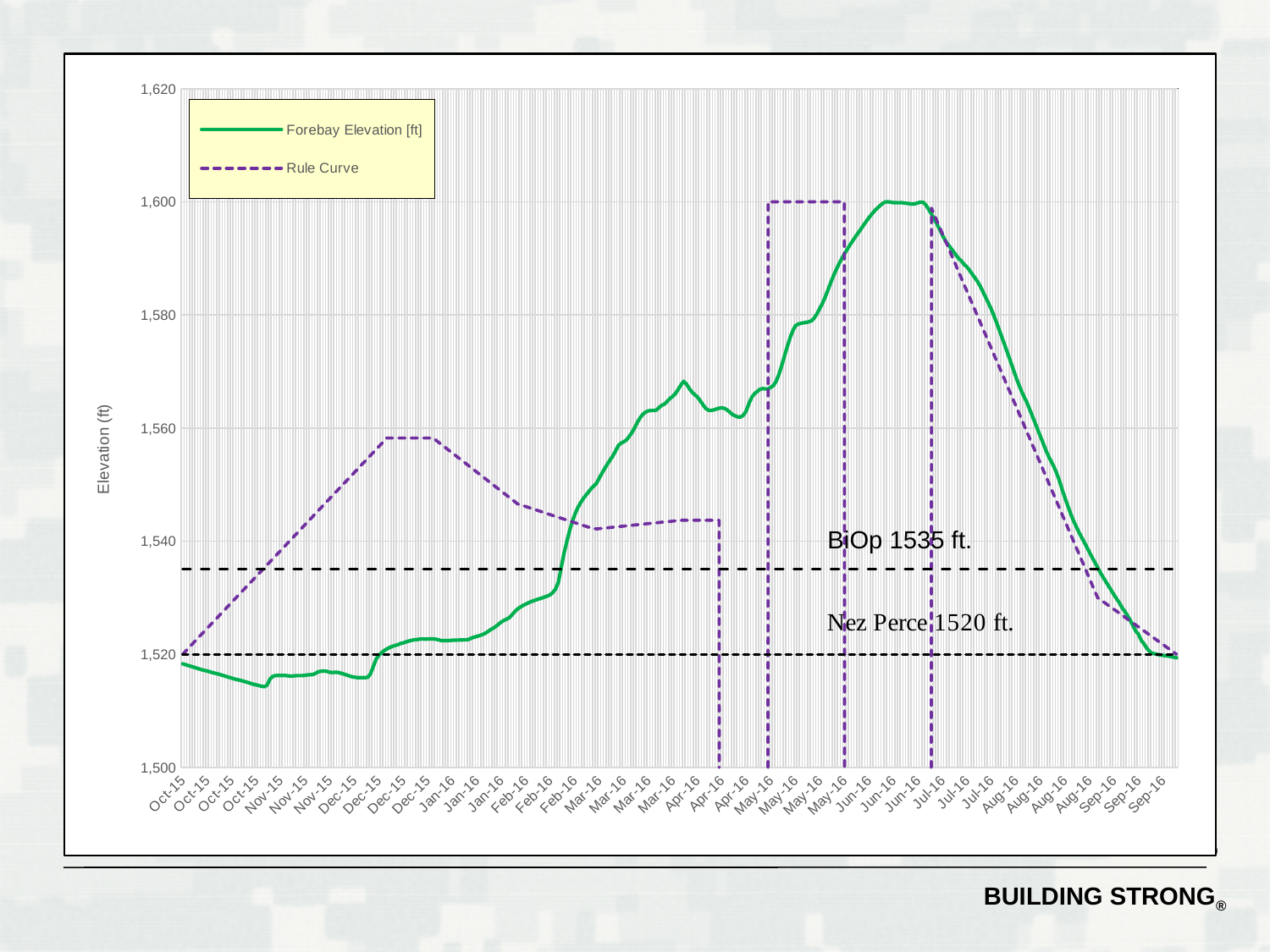
What elevation does the Nez Perce reference line mark? 1520 ft. What are the two series named in the legend? Forebay Elevation [ft] and Rule Curve Is the Rule Curve value in mid Jan-16 greater or less than 1,540? greater In mid Dec-15, which series is higher, Forebay Elevation or Rule Curve? Rule Curve In early Apr-16, which series is higher, Forebay Elevation or Rule Curve? Forebay Elevation How many series does the legend list? 2 What is the label on the vertical axis? Elevation (ft) What kind of chart is shown on the slide? line chart Does the Forebay Elevation rise or fall from Jul-16 to Sep-16? fall What elevation does the BiOp reference line mark? 1535 ft. Is the Forebay Elevation in early Nov-15 greater or less than 1,520? less Is the Forebay Elevation in mid Jun-16 greater or less than 1,580? greater